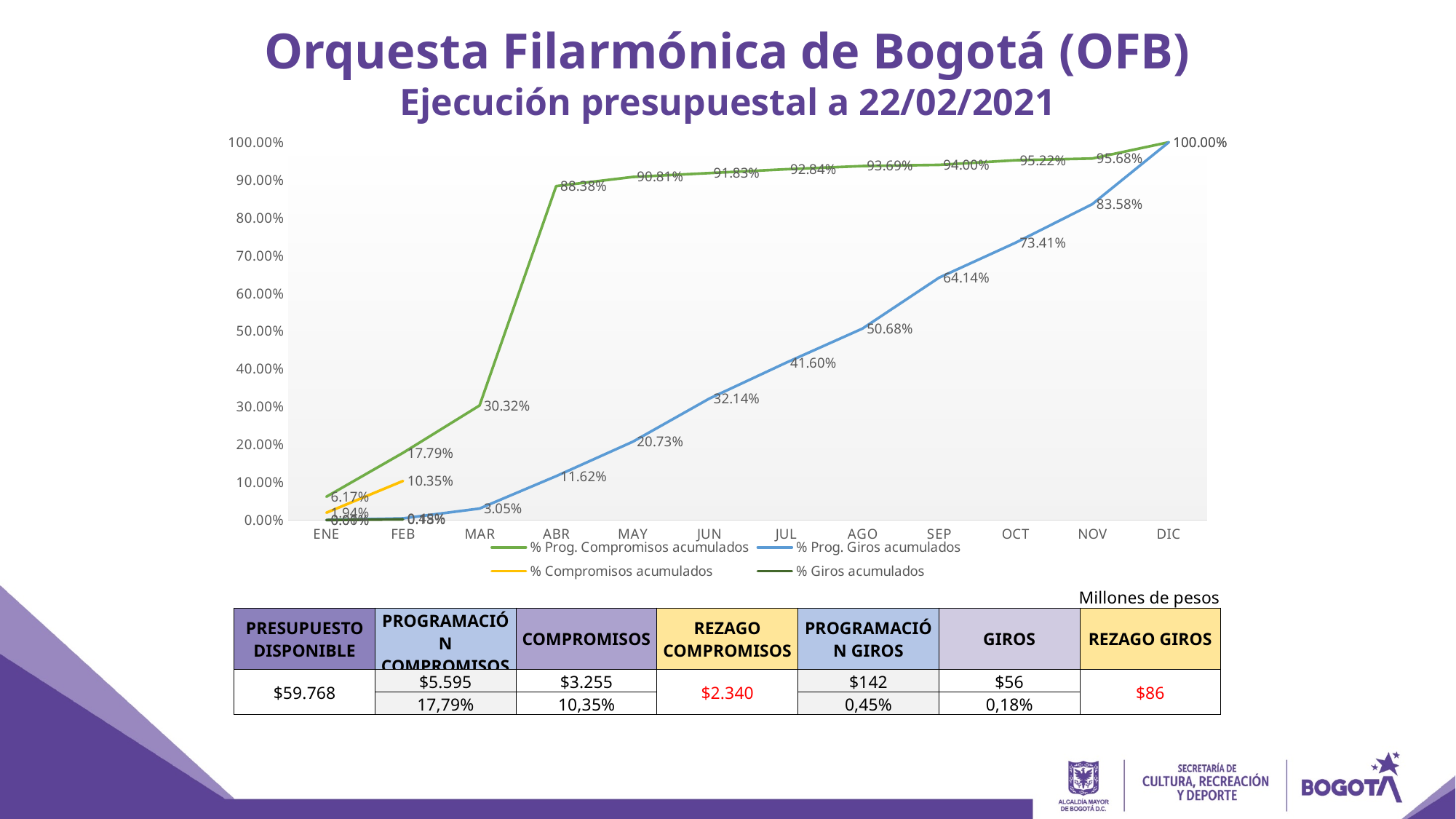
In which month is % Prog. Giros acumulados at its highest? DIC What is the value of % Prog. Giros acumulados in SEP? 64.14% Does % Prog. Giros acumulados rise or fall from ENE to DIC? rise What is the difference between % Prog. Compromisos acumulados and % Prog. Giros acumulados in NOV? 12.10% What is the value of % Prog. Compromisos acumulados in ABR? 88.38% What is the value of % Prog. Compromisos acumulados in MAR? 30.32% In which month is % Prog. Compromisos acumulados at its lowest? ENE What is the value of % Compromisos acumulados in FEB? 10.35% How many series does the chart legend list? 4 What type of chart is shown on the slide? line chart How many months are shown on the x axis of the chart? 12 Which is larger in JUL: % Prog. Compromisos acumulados or % Prog. Giros acumulados? % Prog. Compromisos acumulados